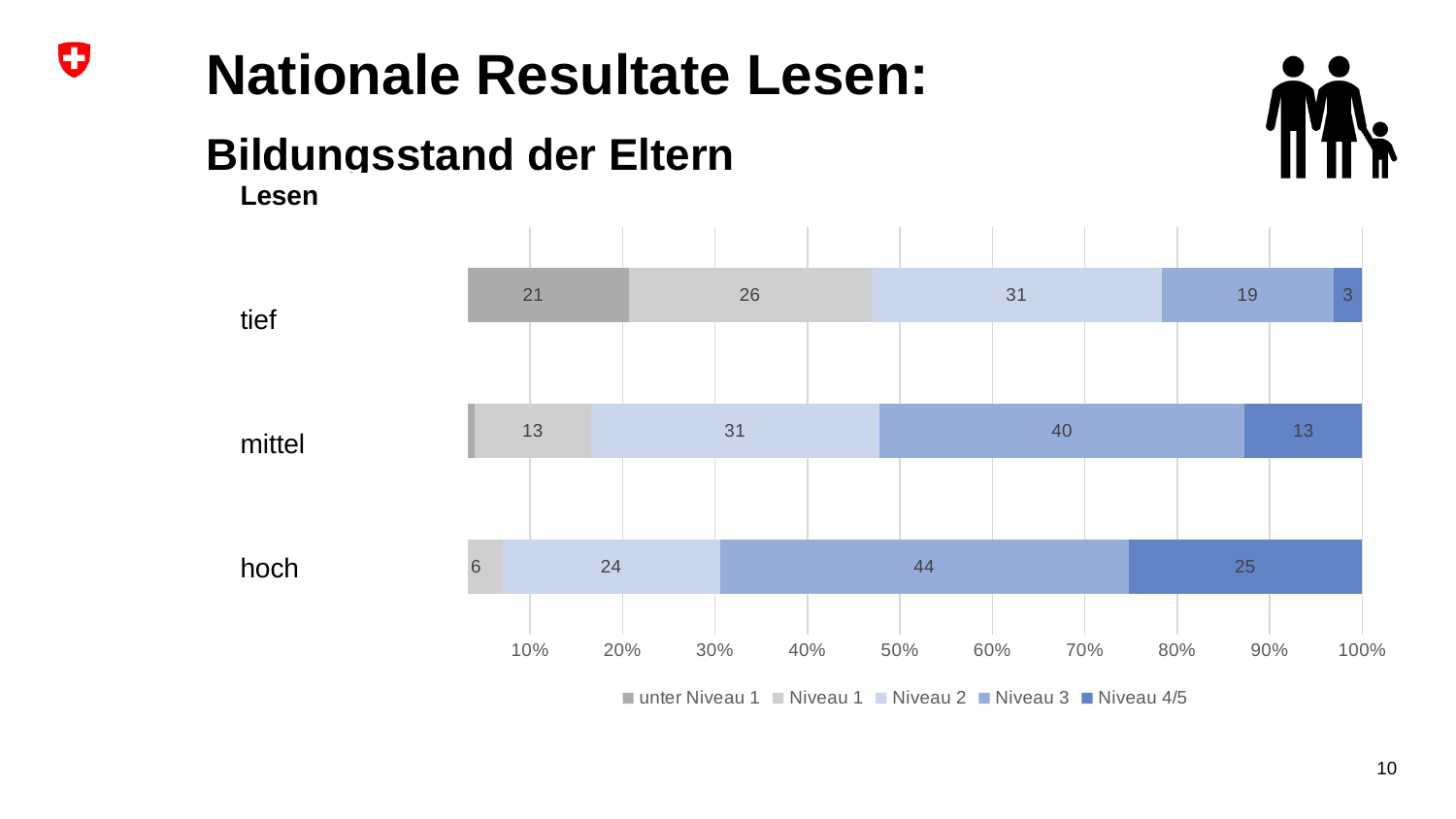
What is the difference between the Niveau 4/5 values for "hoch" and "mittel"? 12 What is the value of Niveau 2 for the category "tief"? 31 What is the difference between the Niveau 3 values for "hoch" and "tief"? 25 What is the value of "unter Niveau 1" for the category "tief"? 21 What kind of chart is shown on the slide? Stacked bar chart Which category has the lowest value for Niveau 4/5? tief What is the value of Niveau 3 for the category "mittel"? 40 How many series does the legend list? 5 Which category has the larger Niveau 2 value, "tief" or "hoch"? tief How many categories are shown on the chart? 3 Which category has the highest value for Niveau 3? hoch What is the value of Niveau 4/5 for the category "hoch"? 25